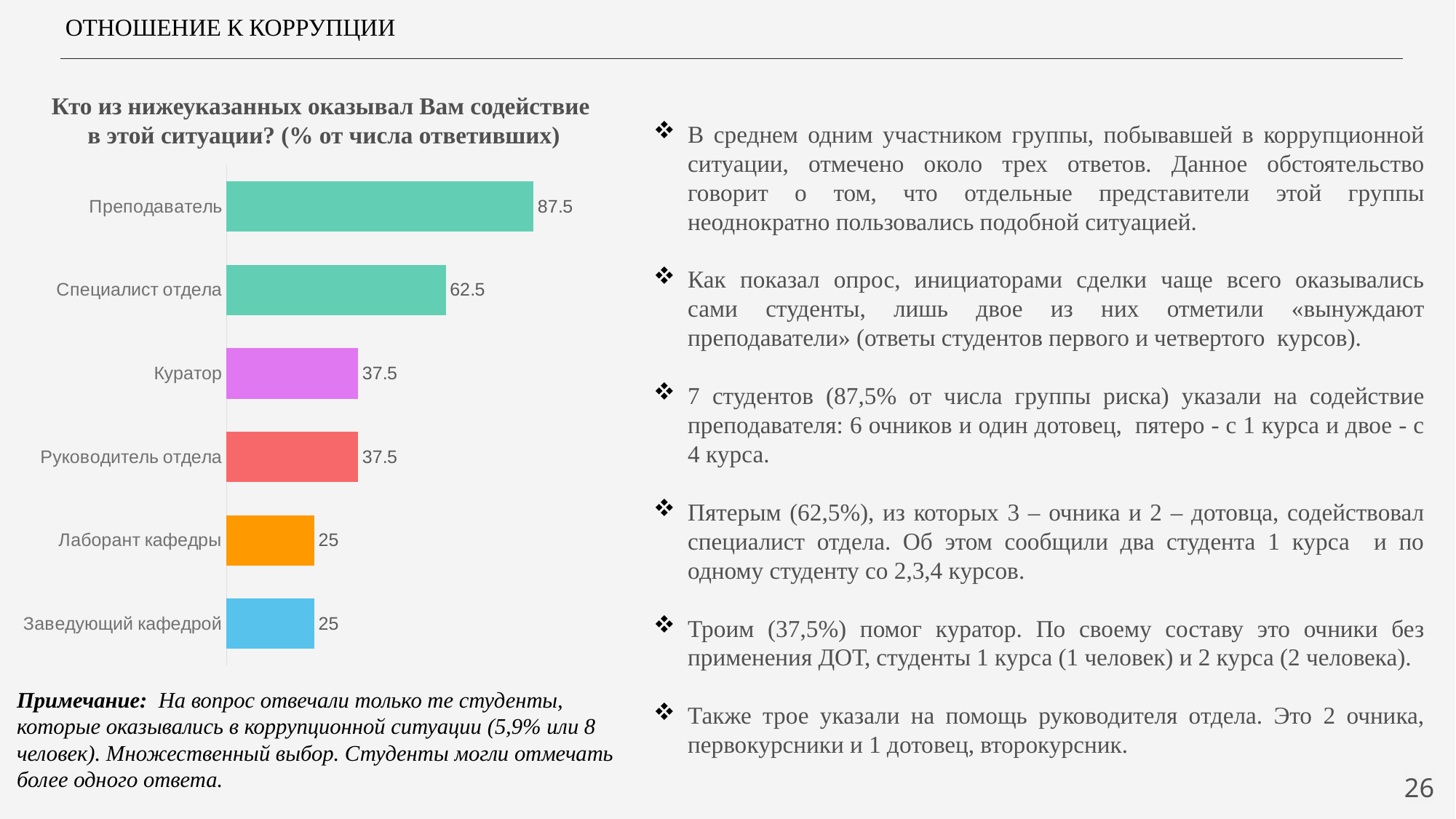
Do the values rise or fall going from the top bar to the bottom bar? fall What kind of chart is shown on the slide? bar chart What value is shown for Специалист отдела? 62.5 What value is shown for Преподаватель? 87.5 Which category has the highest value? Преподаватель What colour is the bar for Лаборант кафедры? orange How many categories are shown in the chart? 6 What value is shown for Лаборант кафедры? 25 What value is shown for Куратор? 37.5 What is the difference between the values for Преподаватель and Специалист отдела? 25 What is the difference between the values for Куратор and Заведующий кафедрой? 12.5 Which is larger, the value for Специалист отдела or the value for Руководитель отдела? Специалист отдела